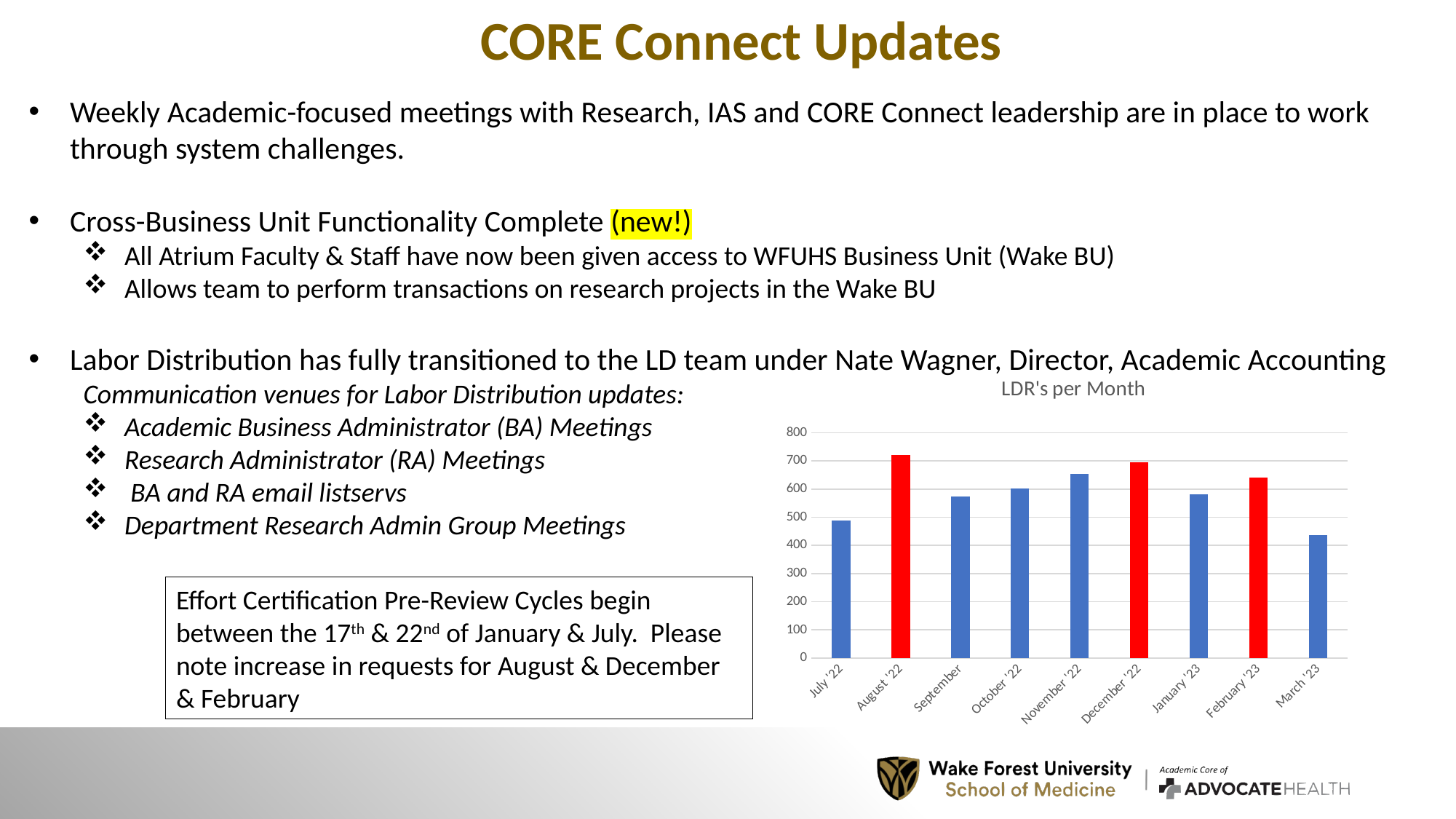
Which is larger, the value for November '22 or the value for September? November '22 Which months are shown with red bars in the chart? August '22, December '22, February '23 Is the value for September greater or less than 600? less What type of chart is shown on the slide? bar chart How many months are plotted in the LDR's per Month chart? 9 Is the value for August '22 greater or less than 700? greater Is the value for March '23 greater or less than 500? less Which month has the lowest number of LDRs? March '23 Which is larger, the value for July '22 or the value for March '23? July '22 Which month has the highest number of LDRs? August '22 What is the title of the chart? LDR's per Month